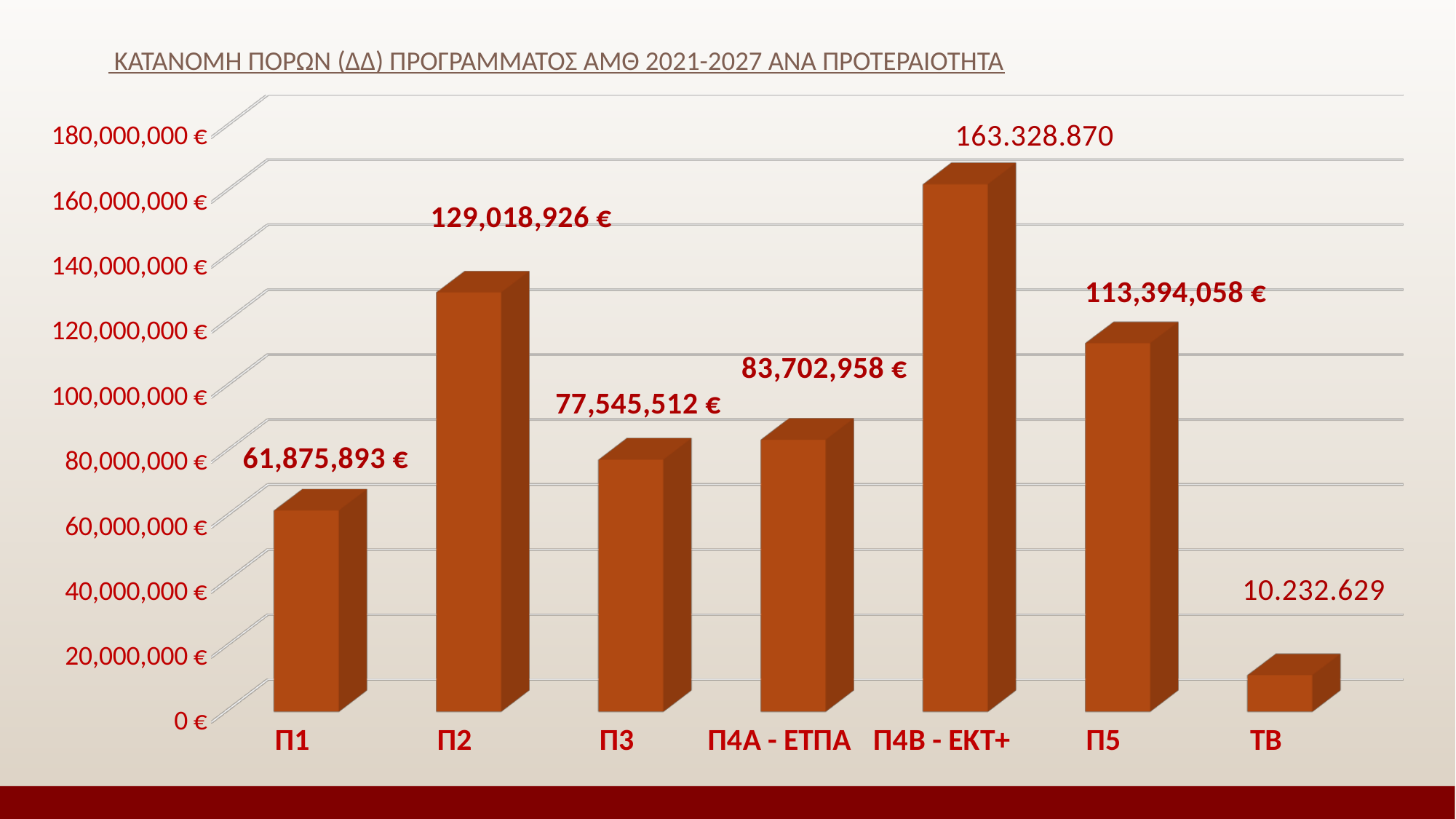
What kind of chart is shown on the slide? bar chart What is the difference between the values for Π4Α - ΕΤΠΑ and Π3? 6,157,446 € What is the difference between the values for Π2 and Π1? 67,143,033 € What is the value for Π2? 129,018,926 € What is the value for ΤΒ? 10.232.629 What is the value for Π4Β - ΕΚΤ+? 163.328.870 Which category has the lowest value? ΤΒ Which is larger, the value for Π5 or the value for Π2? Π2 How many categories are shown on the x axis? 7 What is the value for Π4Α - ΕΤΠΑ? 83,702,958 € What is the value for Π1? 61,875,893 € Which category has the highest value? Π4Β - ΕΚΤ+